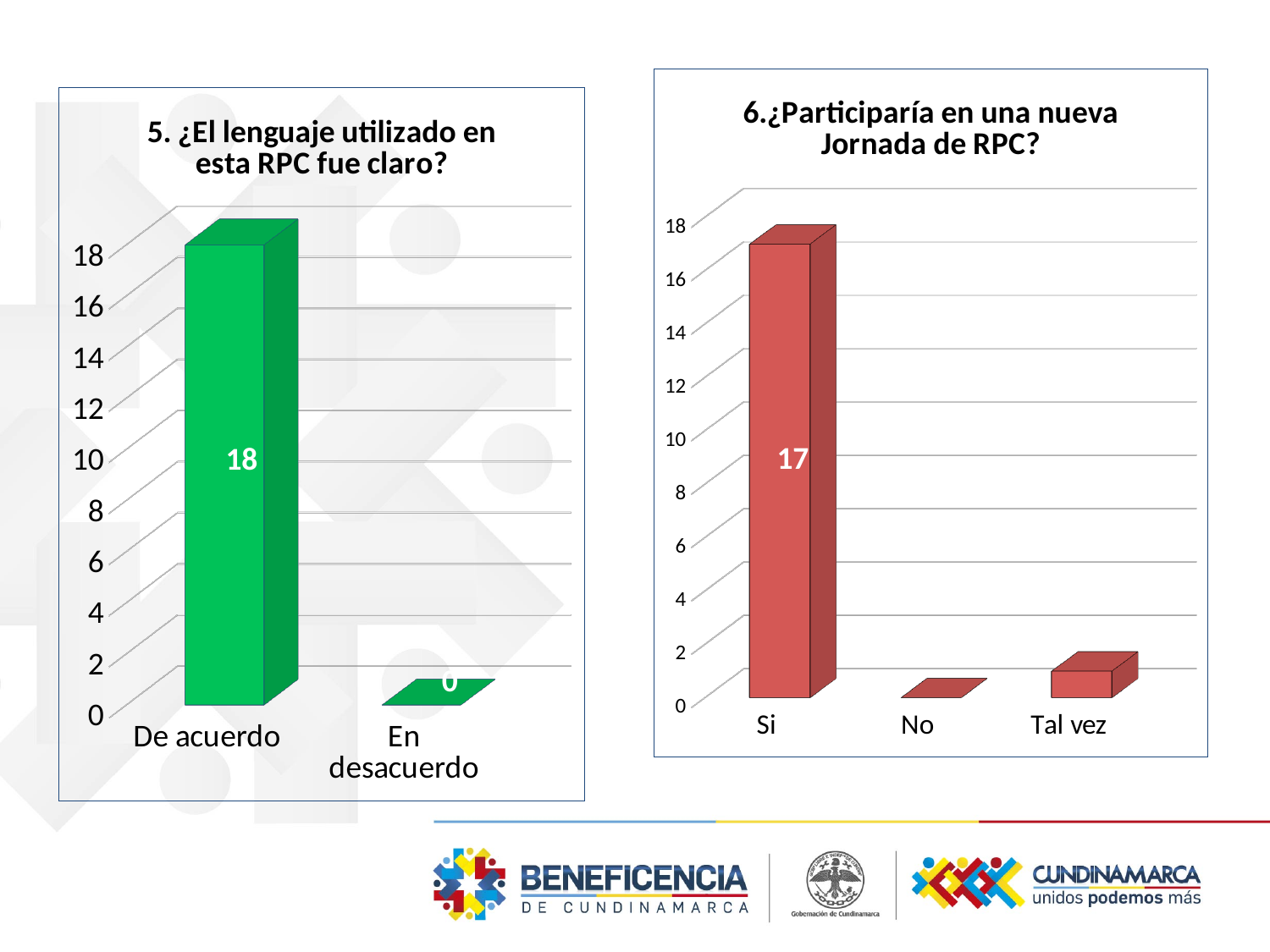
In the chart titled "5. ¿El lenguaje utilizado en esta RPC fue claro?", what is the value for "De acuerdo"? 18 What is the title of the chart on the right of the slide? 6.¿Participaría en una nueva Jornada de RPC? In the chart titled "6.¿Participaría en una nueva Jornada de RPC?", is the value for "Tal vez" greater or less than 4? less In the chart titled "5. ¿El lenguaje utilizado en esta RPC fue claro?", what is the value for "En desacuerdo"? 0 In the chart titled "6.¿Participaría en una nueva Jornada de RPC?", which category has the lowest value? No In the chart titled "6.¿Participaría en una nueva Jornada de RPC?", what is the value for "Si"? 17 In the chart titled "6.¿Participaría en una nueva Jornada de RPC?", which category has the highest value? Si How many categories are shown in the chart titled "6.¿Participaría en una nueva Jornada de RPC?"? 3 What kind of chart is the chart on the left of the slide? Bar chart How many categories are shown in the chart titled "5. ¿El lenguaje utilizado en esta RPC fue claro?"? 2 In the chart titled "5. ¿El lenguaje utilizado en esta RPC fue claro?", what is the difference between the values for "De acuerdo" and "En desacuerdo"? 18 In the chart titled "6.¿Participaría en una nueva Jornada de RPC?", which is larger, the value for "Si" or the value for "Tal vez"? Si